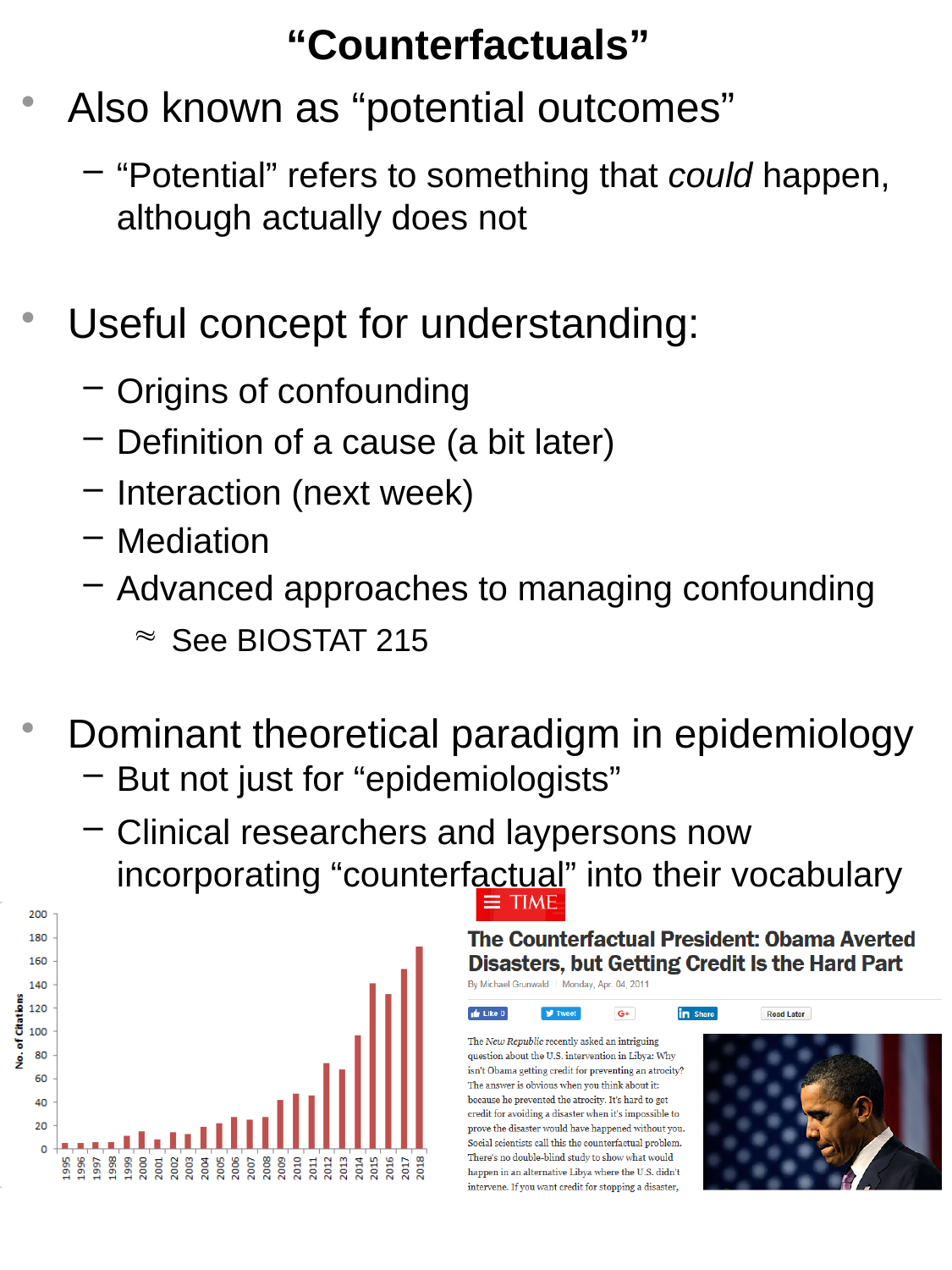
In the bar chart at the bottom left, is the value for 2010 greater or less than 60? less In the bar chart at the bottom left, which year has the highest number of citations? 2018 What kind of chart is shown at the bottom left of the slide? bar chart In the bar chart at the bottom left, is the value for 2016 greater or less than 120? greater In the bar chart at the bottom left, which year has more citations, 2013 or 2014? 2014 In the bar chart at the bottom left, which year has more citations, 2017 or 2018? 2018 In the bar chart at the bottom left, which year has more citations, 2011 or 2012? 2012 In the bar chart at the bottom left, how many years (bars) are plotted? 24 In the bar chart at the bottom left, do the number of citations generally rise or fall from 1995 to 2018? rise In the bar chart at the bottom left, is the value for 2018 greater or less than 160? greater What is the label on the vertical axis of the bar chart at the bottom left? No. of Citations